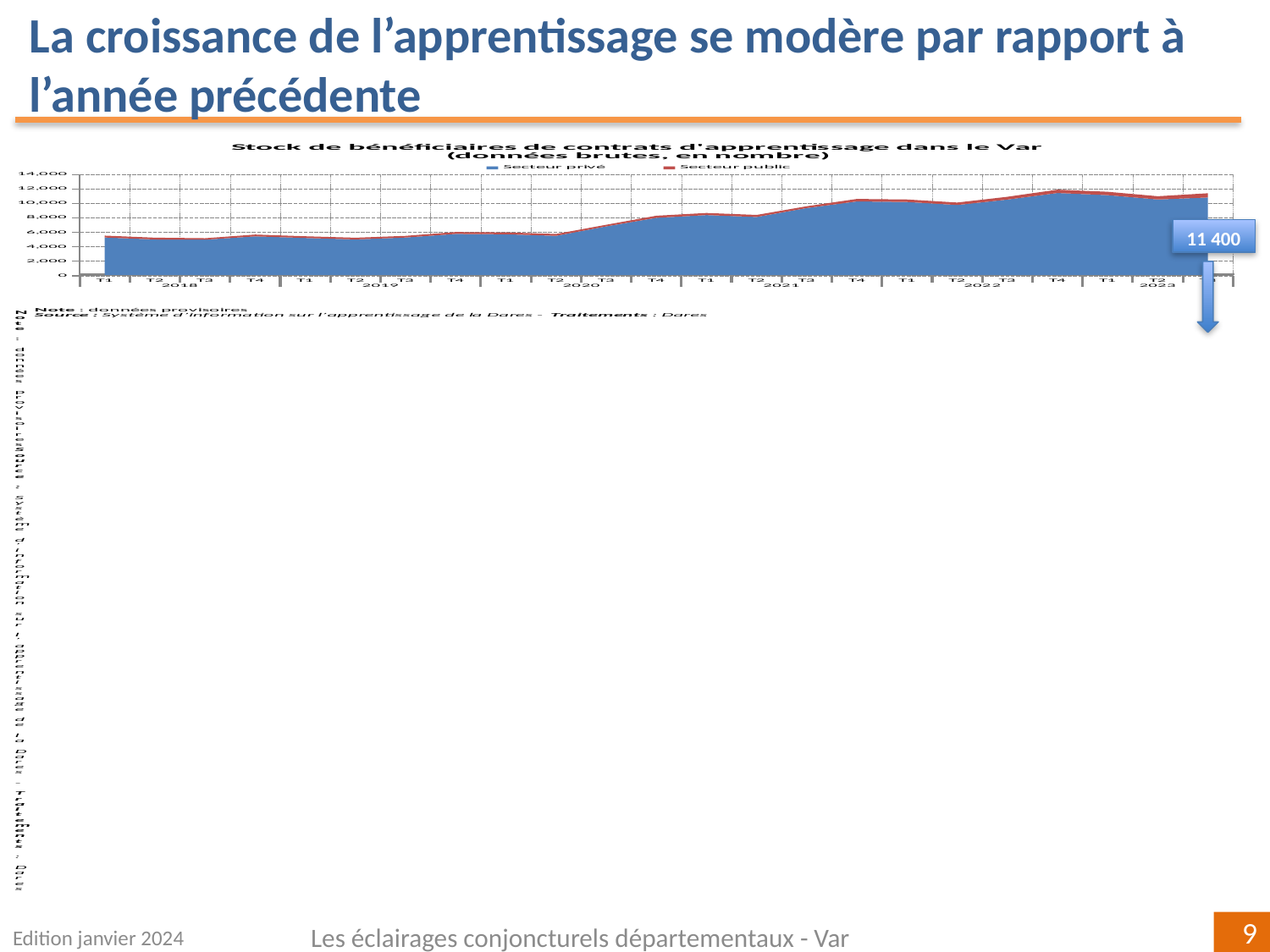
Overall, do the values rise or fall from 2018 to 2023 along the x axis? Rise Is the total value for T2 2020 greater or less than 8,000? less Which is larger, the total value for T4 2022 or for T1 2018? T4 2022 Is the total value for T4 2022 greater or less than 10,000? greater Is the total value for T4 2020 greater or less than 6,000? greater What kind of chart is shown on the slide? Area chart What value does the callout give for the most recent point on the chart? 11 400 How many series does the chart's legend list? 2 How many years are labelled on the x axis of the chart? 6 What are the two series named in the chart's legend? Secteur privé and Secteur public What is the title of the chart? Stock de bénéficiaires de contrats d'apprentissage dans le Var (données brutes, en nombre)